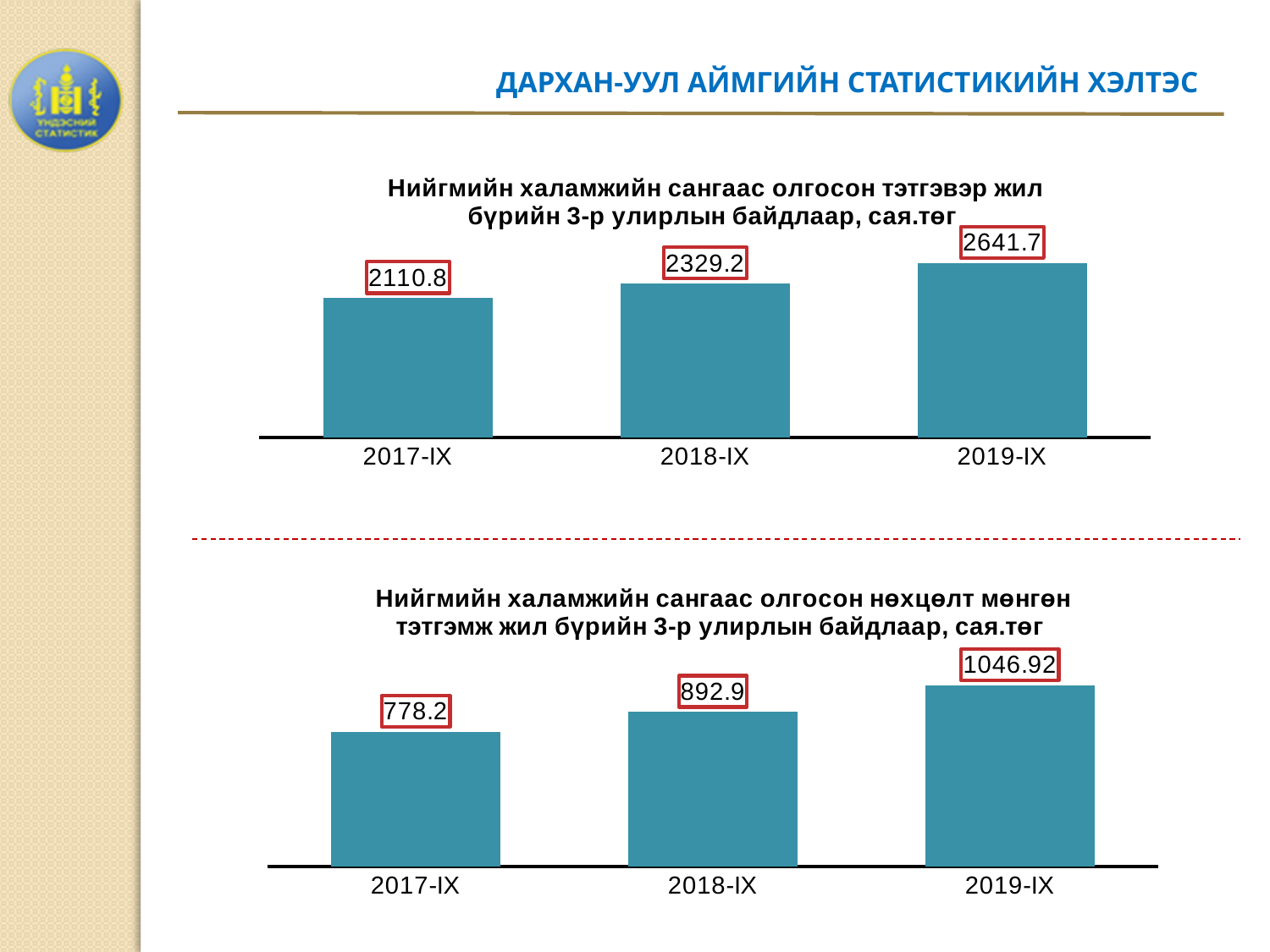
In the bottom chart (conditional cash benefits from the social welfare fund), what is the value for 2019-IX? 1046.92 In the top chart (pensions from the social welfare fund), which period has the highest value? 2019-IX What kind of chart is the top chart on the slide? bar chart In the top chart (pensions from the social welfare fund), what is the difference between the 2019-IX and 2017-IX values? 530.9 In the bottom chart (conditional cash benefits from the social welfare fund), how many periods are shown on the x axis? 3 In the bottom chart (conditional cash benefits from the social welfare fund), what is the difference between the 2018-IX and 2017-IX values? 114.7 In the top chart (pensions from the social welfare fund), what is the value for 2017-IX? 2110.8 In the bottom chart (conditional cash benefits from the social welfare fund), what is the value for 2018-IX? 892.9 In the top chart (pensions from the social welfare fund), what is the value for 2019-IX? 2641.7 In the bottom chart (conditional cash benefits from the social welfare fund), which period has the lowest value? 2017-IX In the top chart (pensions from the social welfare fund), do the values rise or fall from 2017-IX to 2019-IX? rise In the top chart, which is larger: the value for 2018-IX or the value for 2017-IX? 2018-IX